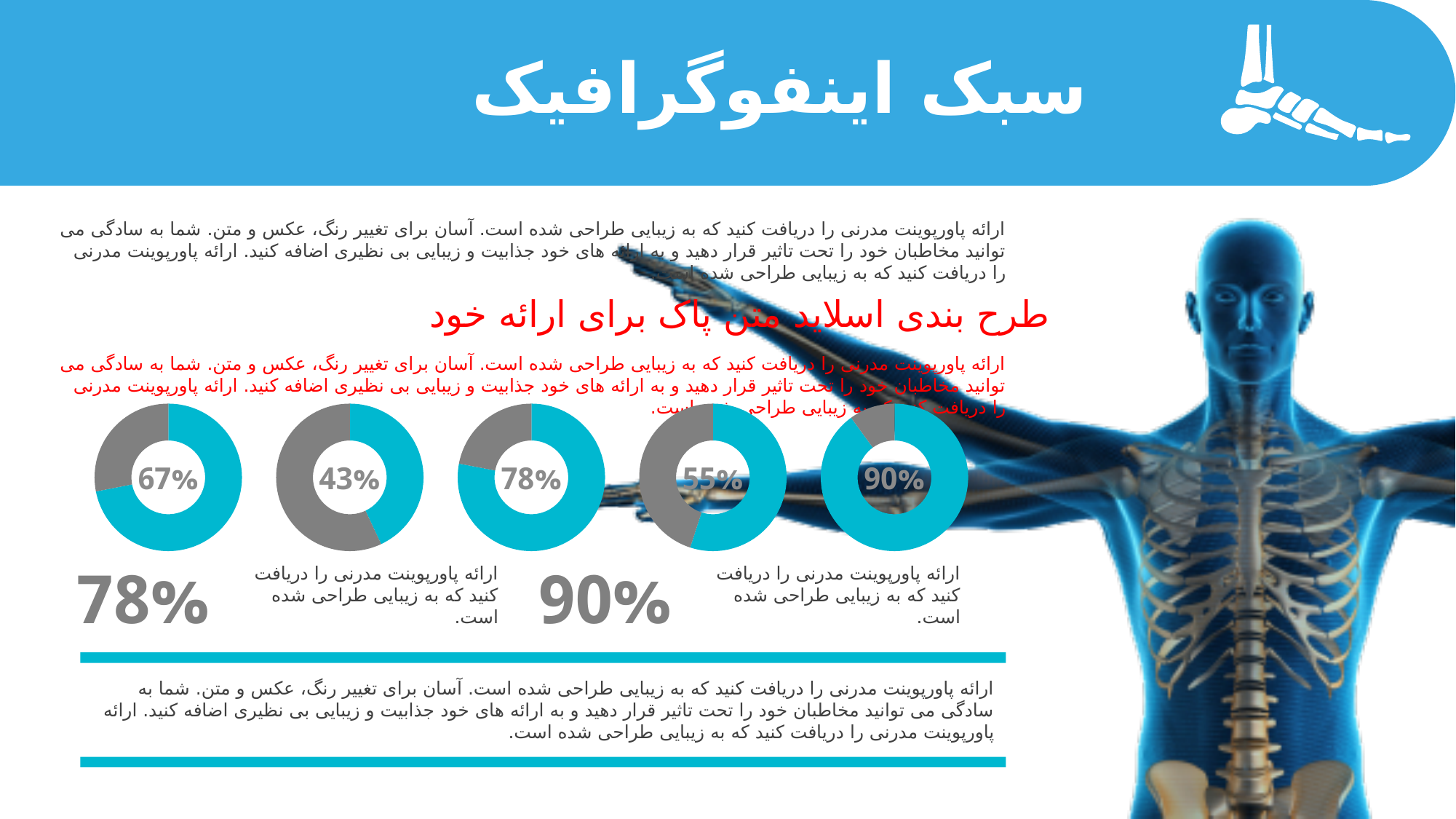
Which donut chart shows the highest percentage? The rightmost one (90%) Which is larger: the percentage in the third donut chart or the percentage in the fourth donut chart? The third donut chart (78%) What is the difference between the percentage in the rightmost donut chart and the percentage in the leftmost donut chart? 23% How many donut charts are shown on the slide? 5 What percentage is shown in the centre of the middle (third) donut chart? 78% What percentage is shown in the centre of the rightmost donut chart? 90% Which donut chart shows the lowest percentage? The second from the left (43%) What kind of chart is used for the five percentage figures in the middle of the slide? Donut chart What percentage is shown in the centre of the fourth donut chart from the left? 55% What percentage is shown in the centre of the second donut chart from the left? 43% What colour is used for the filled (highlighted) portion of each donut chart? Cyan (light blue) What percentage is shown in the centre of the leftmost donut chart? 67%